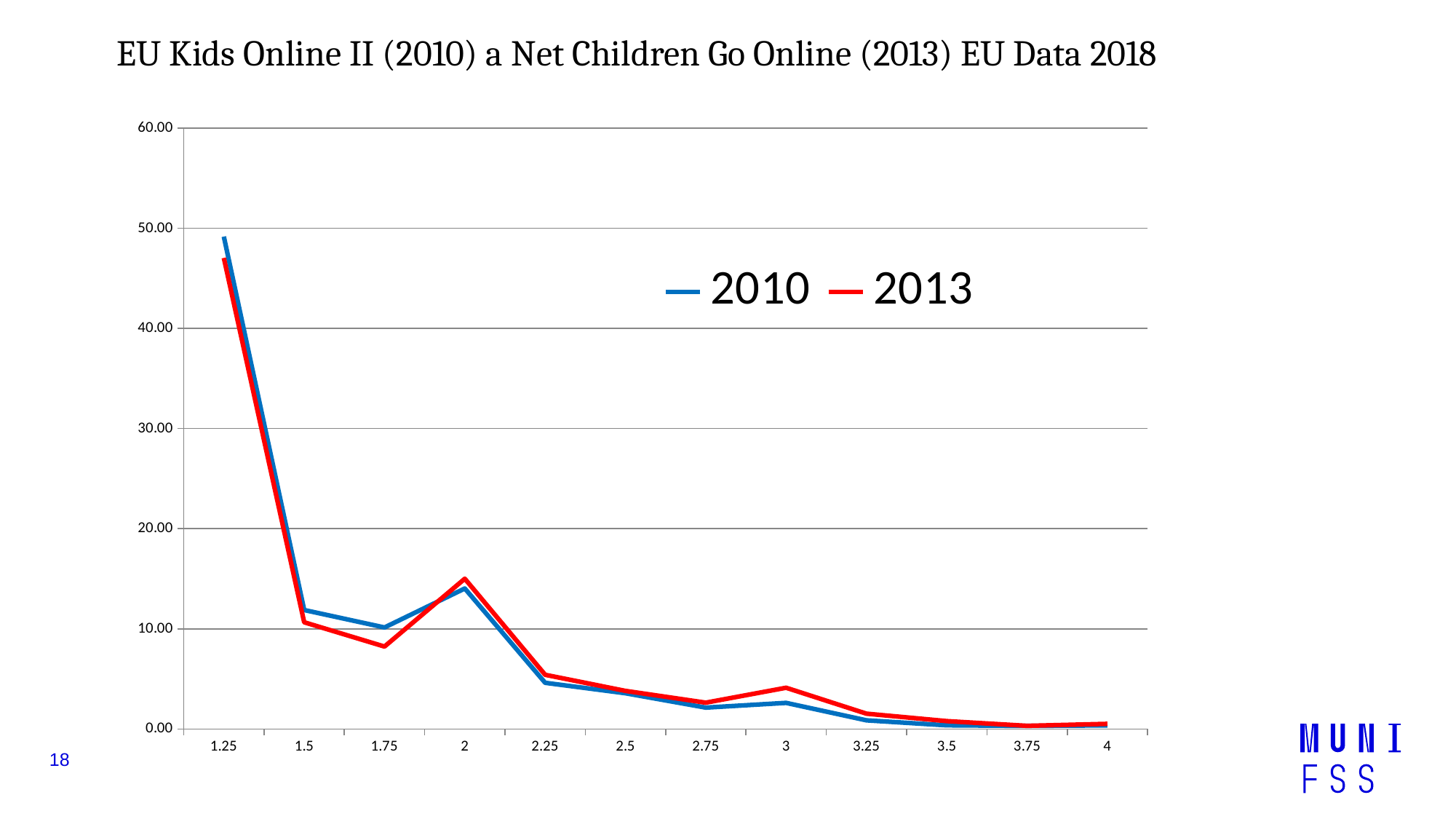
Is the value for the 2010 series at 2 greater or less than 10.00? greater At x = 3, which series has the higher value, 2010 or 2013? 2013 At x = 1.75, which series has the higher value, 2010 or 2013? 2010 What colour is the line for the 2013 series? red How many series does the legend list? 2 Is the value for the 2010 series at 1.25 greater or less than 40.00? greater Is the value for the 2013 series at 1.75 greater or less than 10.00? less At which x-axis value does the 2010 series reach its highest point? 1.25 How many points are plotted along the x axis for each series? 12 Overall, do the values rise or fall as the x axis goes from 1.25 to 4? fall At which x-axis value does the 2013 series reach its highest point? 1.25 What kind of chart is shown on the slide? line chart